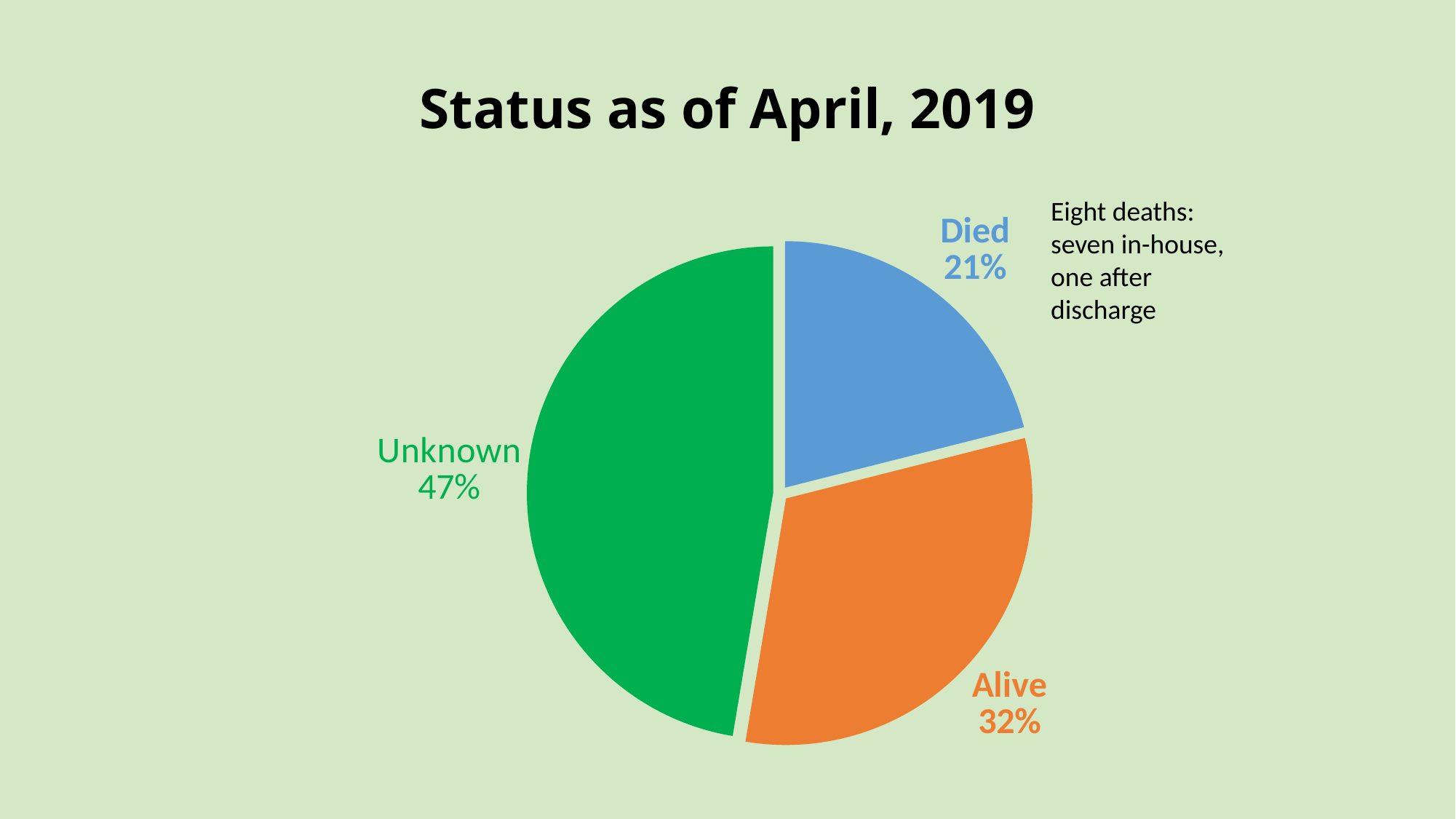
What is the title of the chart? Status as of April, 2019 What percentage of the pie is labelled Alive? 32% What percentage of the pie is labelled Unknown? 47% How many slices does the pie chart have? 3 Which category has the smallest share of the pie? Died What kind of chart is shown on the slide? pie chart Which slice is larger, Alive or Died? Alive What is the difference in percentage points between the Alive and Died slices? 11 What is the difference in percentage points between the Unknown and Alive slices? 15 What colour is the Died slice? blue Which category has the largest share of the pie? Unknown What percentage of the pie is labelled Died? 21%